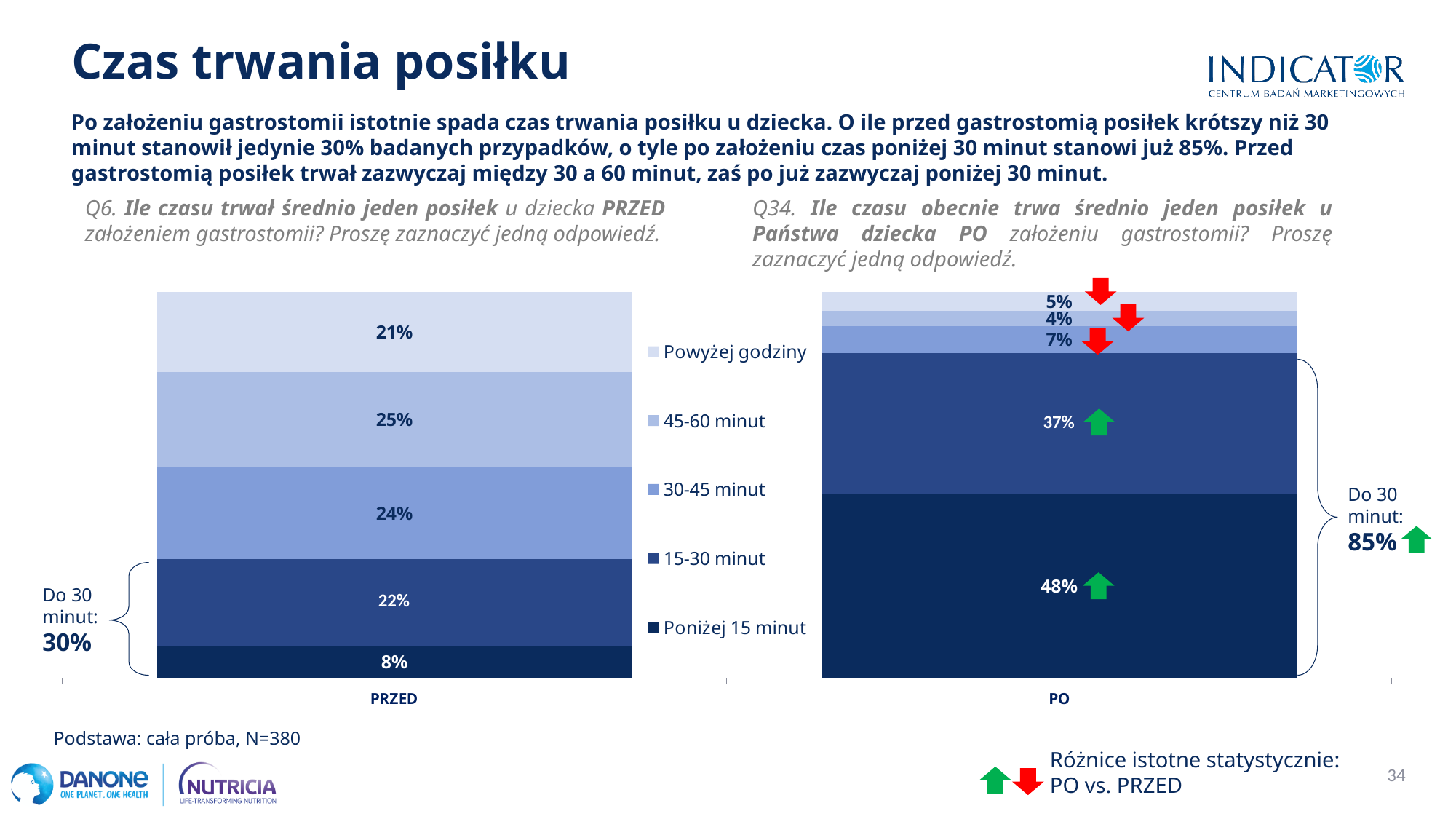
Which is larger: the '30-45 minut' value for PRZED or for PO? PRZED How many series does the legend list? 5 What is the difference between the '15-30 minut' values for PO and PRZED? 15% What is the value for 'Poniżej 15 minut' in the PO bar? 48% What is the value for 'Powyżej godziny' in the PO bar? 5% Which segment is the smallest in the PRZED bar? Poniżej 15 minut What is the combined share of 'Do 30 minut' shown for the PO bar? 85% What type of chart is shown on the slide? stacked bar chart Which segment is the largest in the PO bar? Poniżej 15 minut How many bars (categories) are plotted on the x axis? 2 What is the value for 'Poniżej 15 minut' in the PRZED bar? 8% What is the value for '45-60 minut' in the PRZED bar? 25%